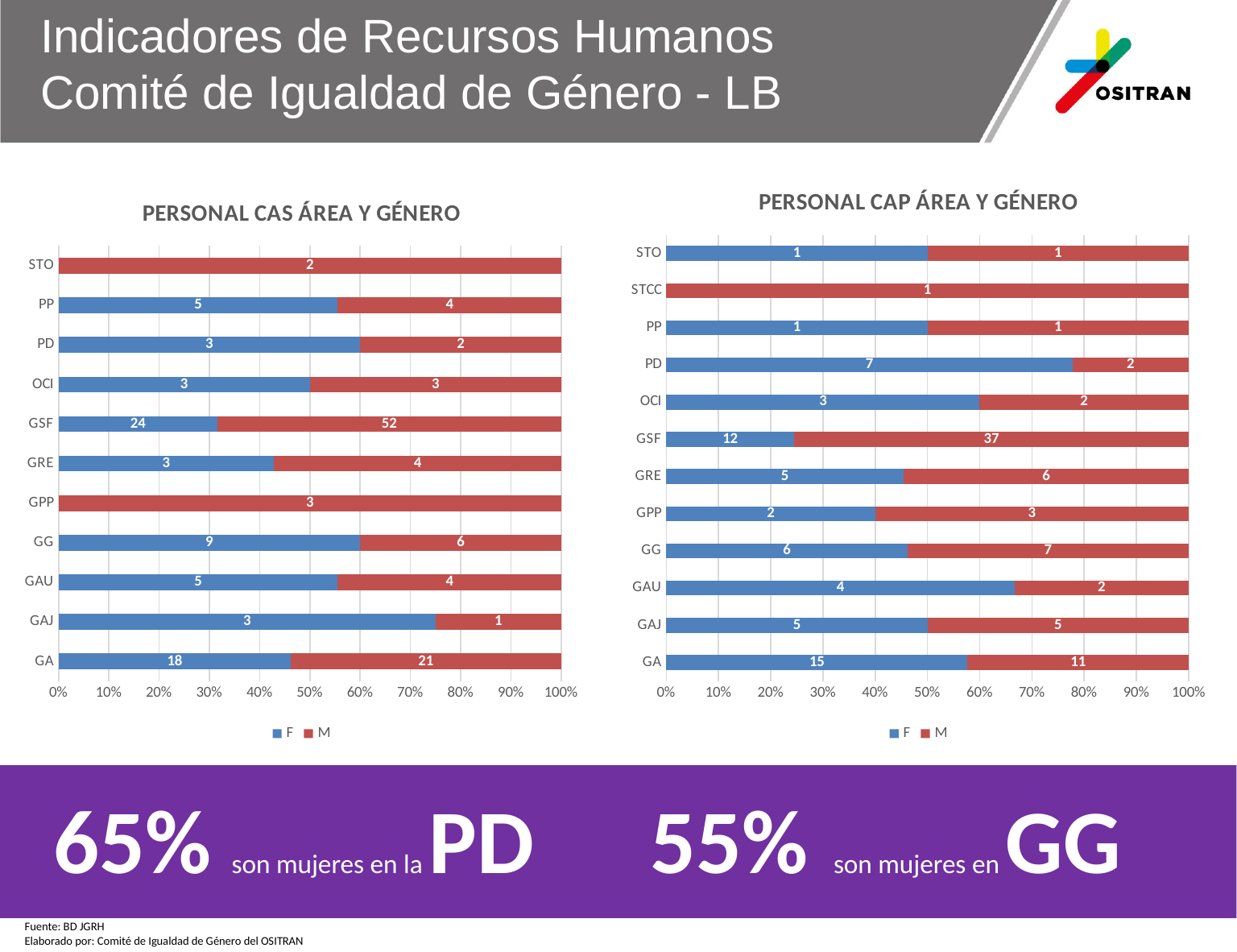
In the PERSONAL CAS ÁREA Y GÉNERO chart, is the share of F in GAJ greater or less than 70%? greater How many areas are listed in the PERSONAL CAP ÁREA Y GÉNERO chart? 12 In the PERSONAL CAP ÁREA Y GÉNERO chart, which is larger in GG, F or M? M In the PERSONAL CAS ÁREA Y GÉNERO chart, what is the value for F in GA? 18 In the PERSONAL CAS ÁREA Y GÉNERO chart, which area has the highest value for F? GSF In the PERSONAL CAP ÁREA Y GÉNERO chart, what is the value for F in PD? 7 In the PERSONAL CAP ÁREA Y GÉNERO chart, what is the value for M in GSF? 37 In the PERSONAL CAS ÁREA Y GÉNERO chart, what is the total of the GSF bar (F plus M)? 76 In the PERSONAL CAS ÁREA Y GÉNERO chart, what is the value for M in GSF? 52 How many series does the legend of the PERSONAL CAS ÁREA Y GÉNERO chart list? 2 In the PERSONAL CAP ÁREA Y GÉNERO chart, what is the difference between M and F in GA? 4 What kind of chart is PERSONAL CAS ÁREA Y GÉNERO? Stacked bar chart